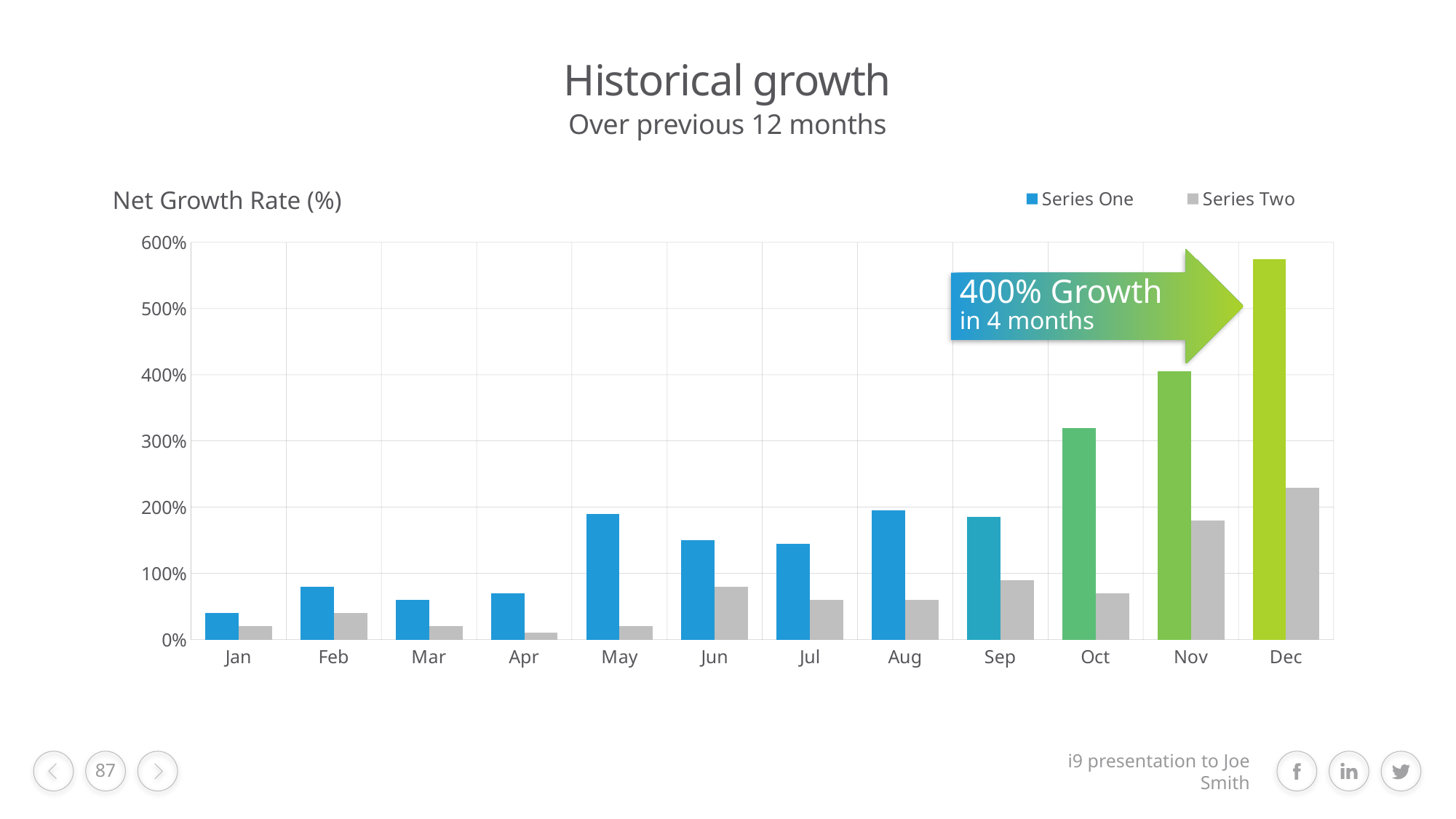
Is the Series Two value for Nov greater or less than 200%? less Which month has the highest value for Series One? Dec Which month has the lowest value for Series One? Jan Which month has the lowest value for Series Two? Apr What is the label on the vertical axis of the chart? Net Growth Rate (%) Which is larger for Series One, the value for Aug or the value for Jul? Aug What kind of chart is shown on the slide? Bar chart Do the Series One values rise or fall from Sep to Dec? Rise How many months are shown on the x axis? 12 Is the Series One value for Oct greater or less than 300%? greater Is the Series One value for Dec greater or less than 500%? greater How many series does the legend list? 2